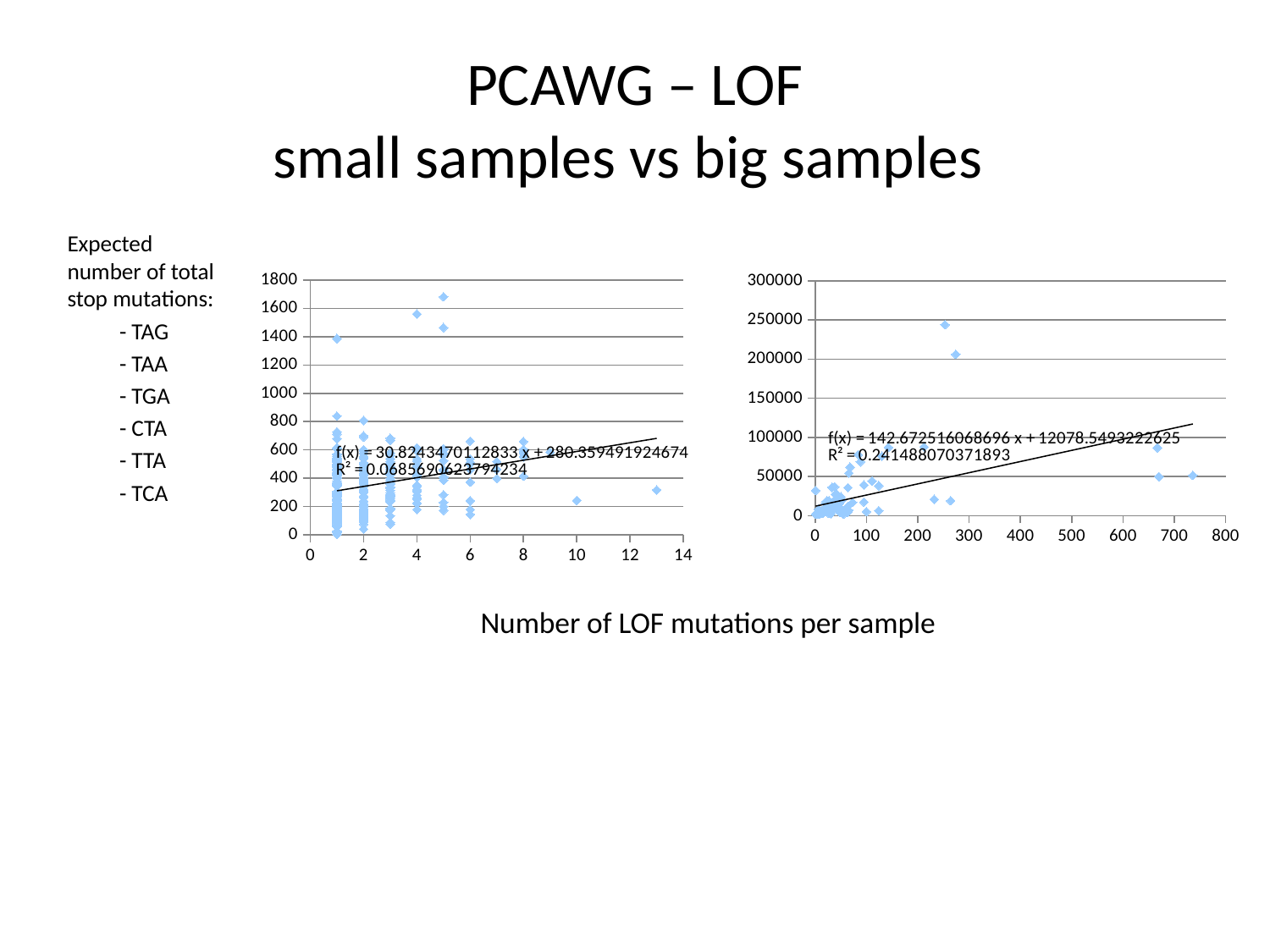
On the left chart, does the fitted trendline rise or fall as the x value increases? rises On the right chart, does the fitted trendline rise or fall as the x value increases? rises What is the maximum value shown on the x axis of the left chart? 14 What kind of chart is the left chart on the slide? scatter chart On the left chart, is the value of the point at x = 13 greater or less than 400? less On the right chart, what is the R² value printed for the trendline? R² = 0.241488070371893 On the left chart, is the value of the point at x = 10 greater or less than 400? less On the left chart, what is the R² value printed for the trendline? R² = 0.0685690623794234 On the left chart, is the highest plotted point greater or less than 1600? greater How many charts are shown on the slide? 2 What is the maximum value shown on the y axis of the right chart? 300000